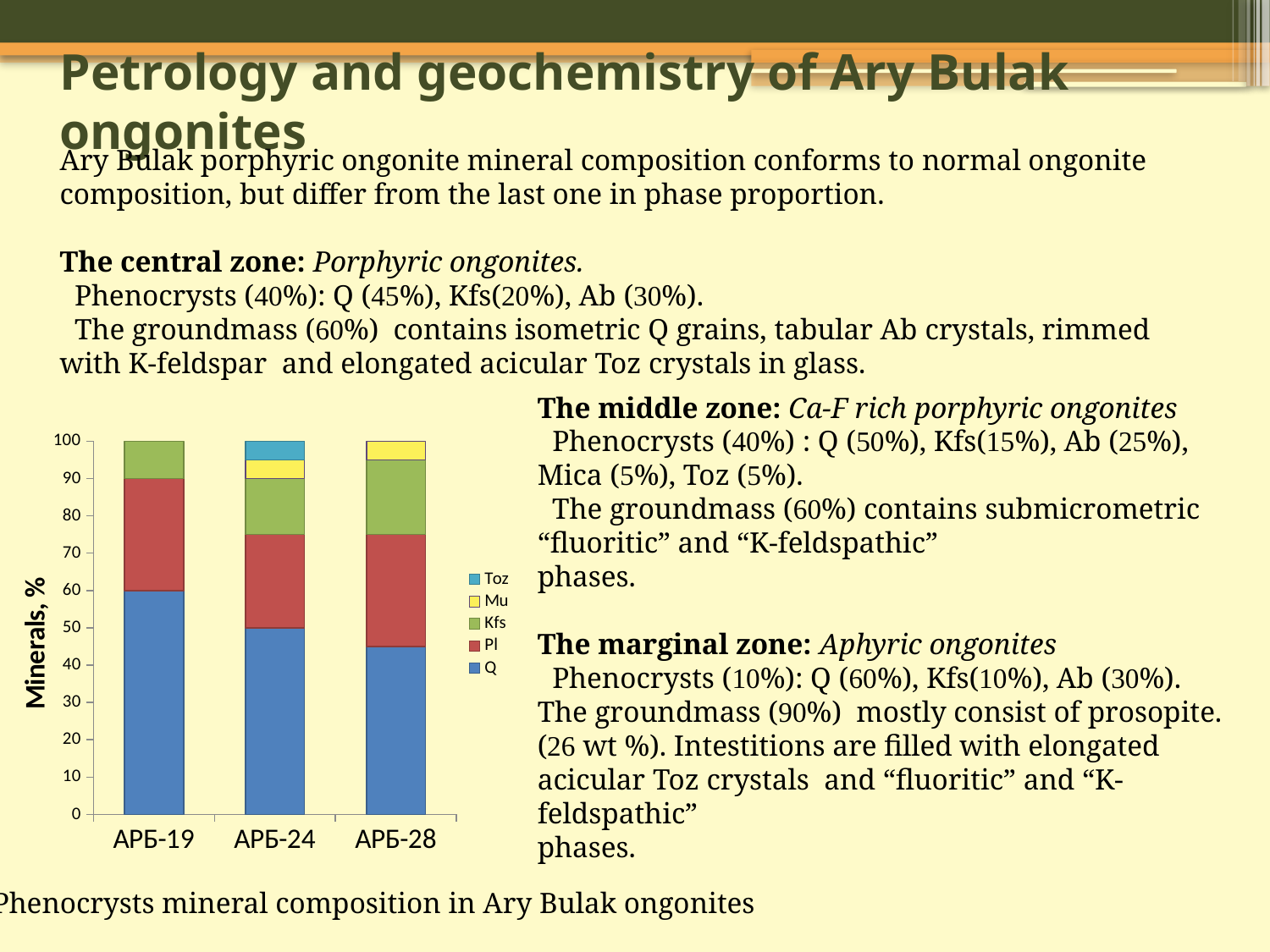
How many samples (categories) are shown on the x axis of the chart? 3 Which sample has a larger Kfs segment, АРБ-19 or АРБ-28? АРБ-28 Which sample has the highest Q value in the chart? АРБ-19 Is the Q value for АРБ-28 greater or less than 50? less Which mineral is shown in blue at the bottom of each stacked bar? Q What is the Q value for АРБ-24 in the chart? 50 What is the Q value for АРБ-19 in the chart? 60 What is the total height of the stacked bar for АРБ-28? 100 Which sample has the lowest Q value in the chart? АРБ-28 How many series does the chart legend list? 5 What kind of chart is shown on the slide? stacked bar chart What is the label of the y axis of the chart? Minerals, %